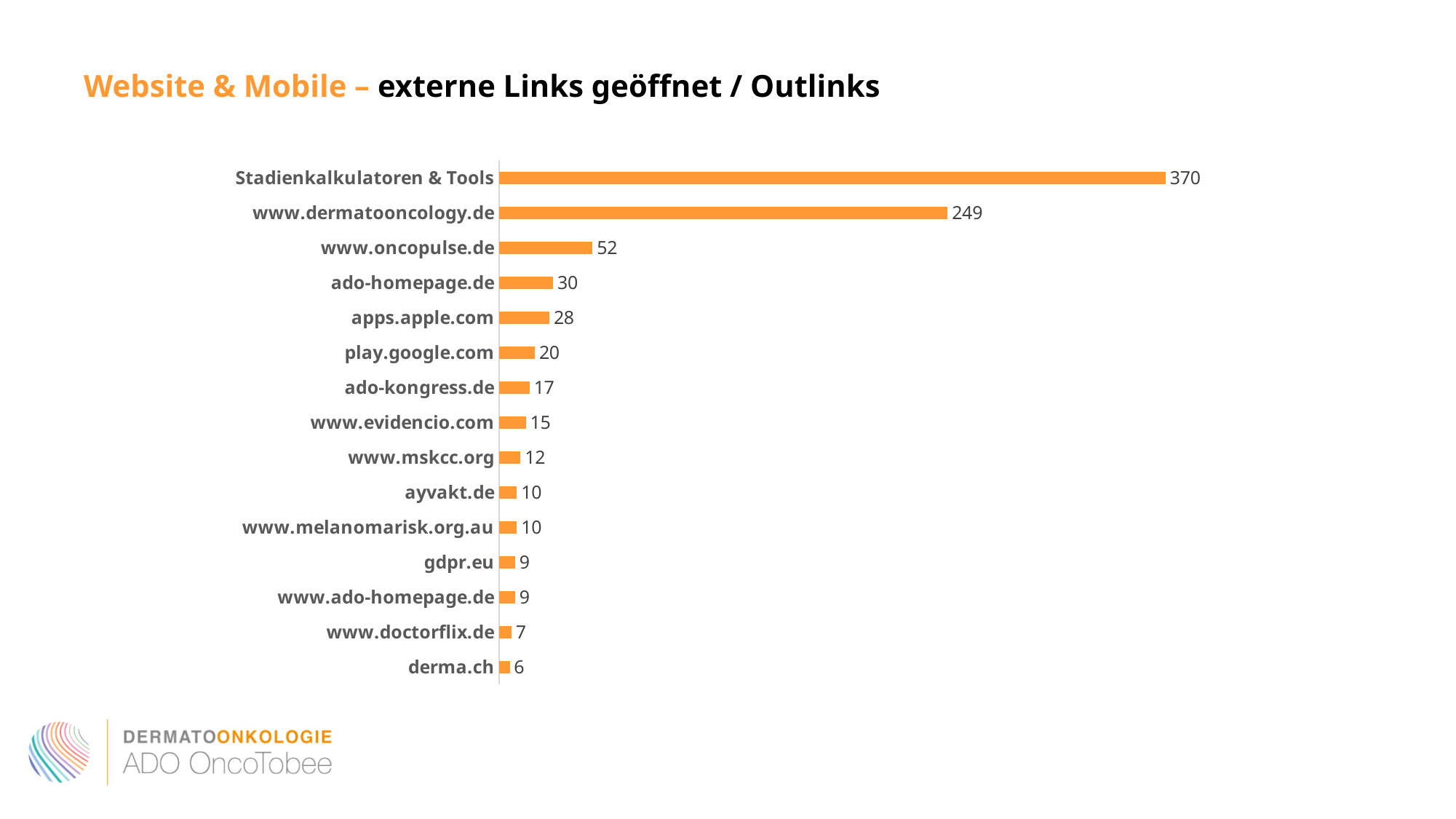
What is the value for www.oncopulse.de? 52 What is the value for www.mskcc.org? 12 What kind of chart is shown on the slide? Bar chart What is the difference between the values for ado-homepage.de and apps.apple.com? 2 What colour are the bars in the chart? Orange How many categories are shown in the chart? 15 What is the value for play.google.com? 20 Which category has the highest value? Stadienkalkulatoren & Tools Which is larger, the value for ado-kongress.de or the value for www.evidencio.com? ado-kongress.de Which category has the lowest value? derma.ch What is the value for Stadienkalkulatoren & Tools? 370 What is the difference between the values for Stadienkalkulatoren & Tools and www.dermatooncology.de? 121